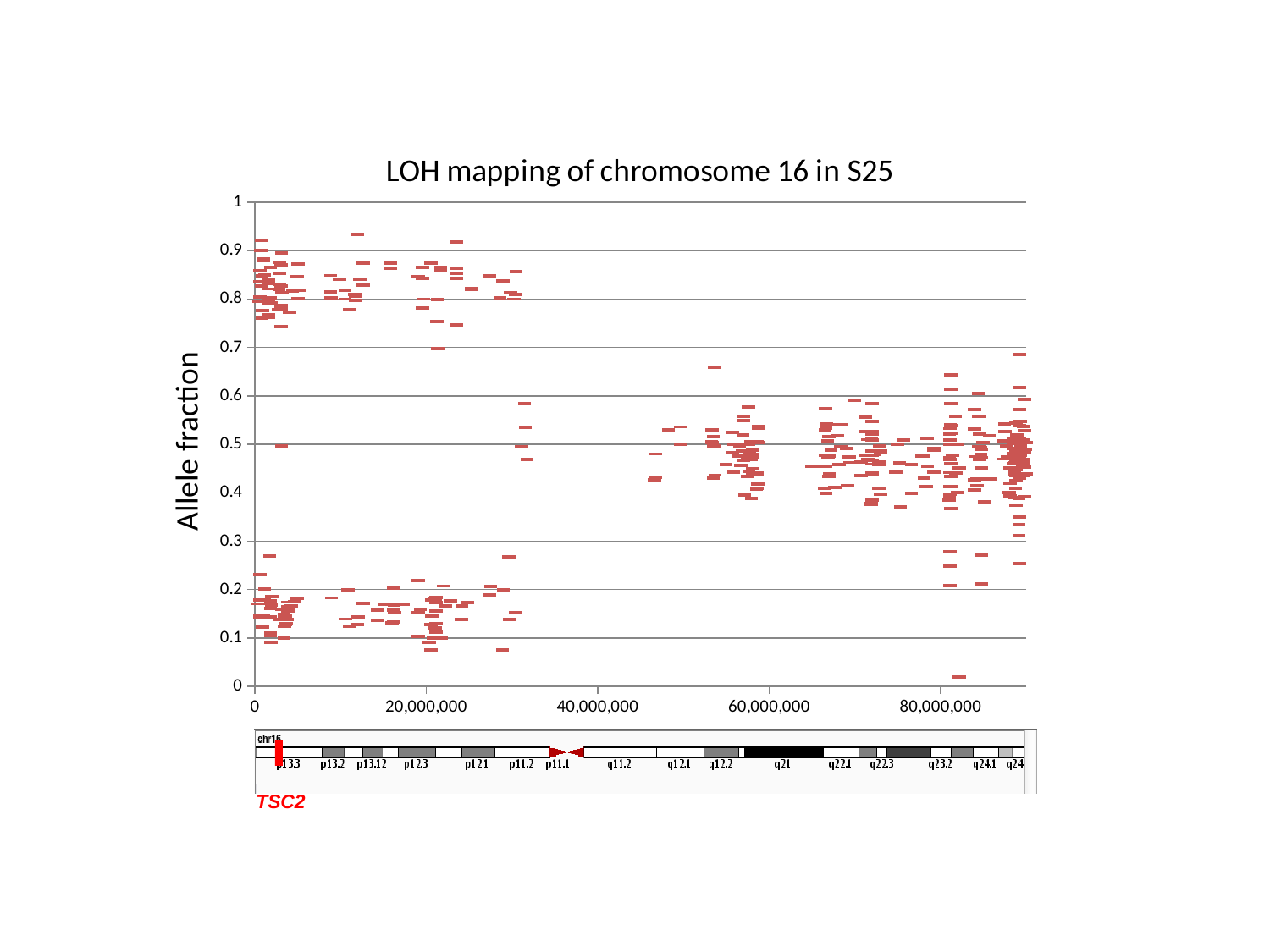
Is the upper cluster of points near x = 0 greater or less than 0.7? greater What kind of chart is shown on the slide? scatter plot Is the highest plotted allele fraction greater or less than 0.9? greater Is the lowest plotted allele fraction greater or less than 0.1? less What is the title of the chart? LOH mapping of chromosome 16 in S25 What is the label of the y axis? Allele fraction